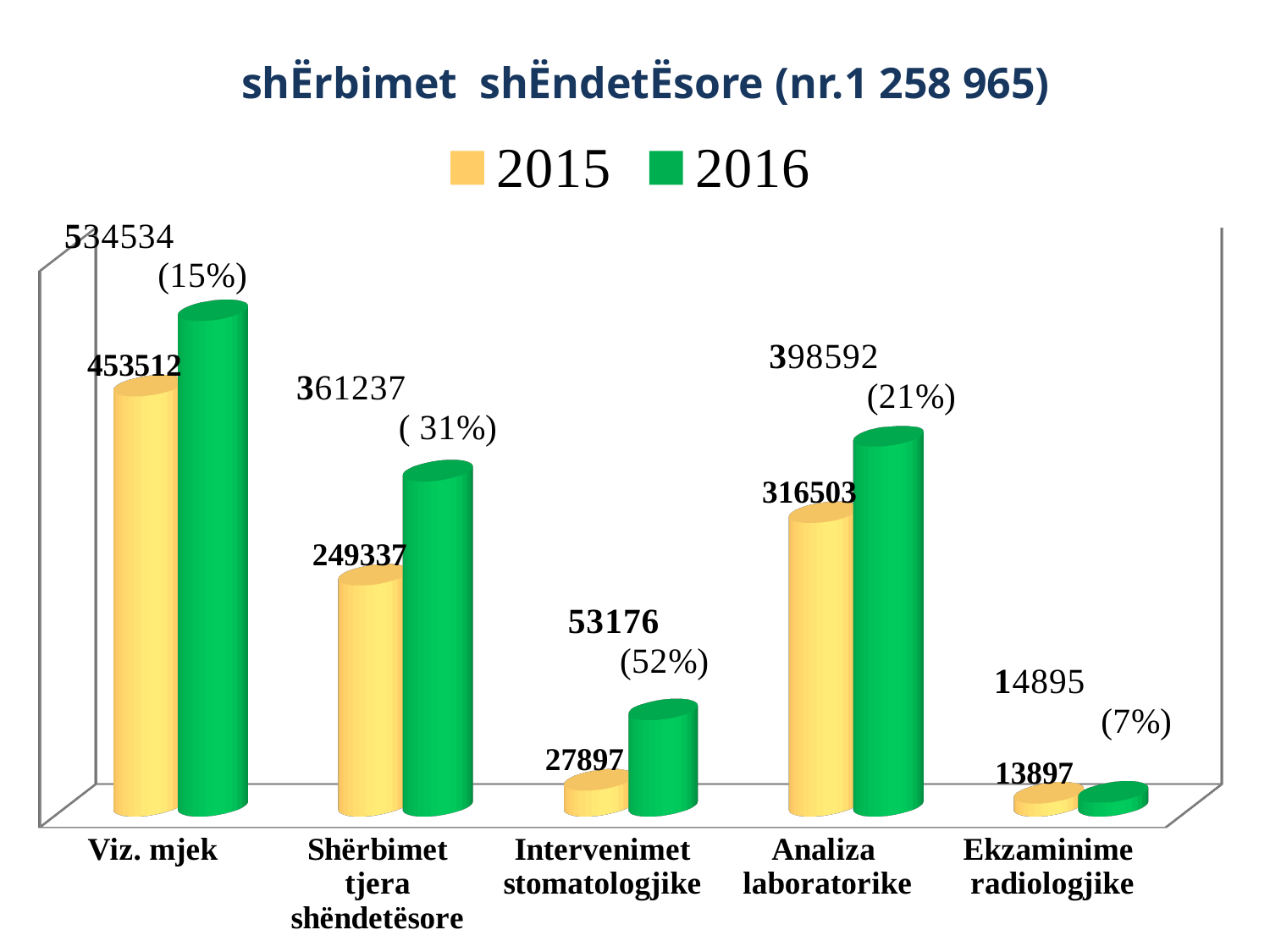
What is the difference between the 2016 and 2015 values for Viz. mjek? 81022 What kind of chart is shown on the slide? Bar chart Which category has the lowest 2015 value? Ekzaminime radiologjike What is the 2015 value for Intervenimet stomatologjike? 27897 Which is larger: the 2016 value for Shërbimet tjera shëndetësore or the 2015 value for Analiza laboratorike? 2016 value for Shërbimet tjera shëndetësore What is the 2015 value for Analiza laboratorike? 316503 What is the 2016 value for Ekzaminime radiologjike? 14895 Which category has the highest 2016 value? Viz. mjek What is the 2016 value for Viz. mjek? 534534 How many series does the legend list? 2 How many categories are shown on the x axis? 5